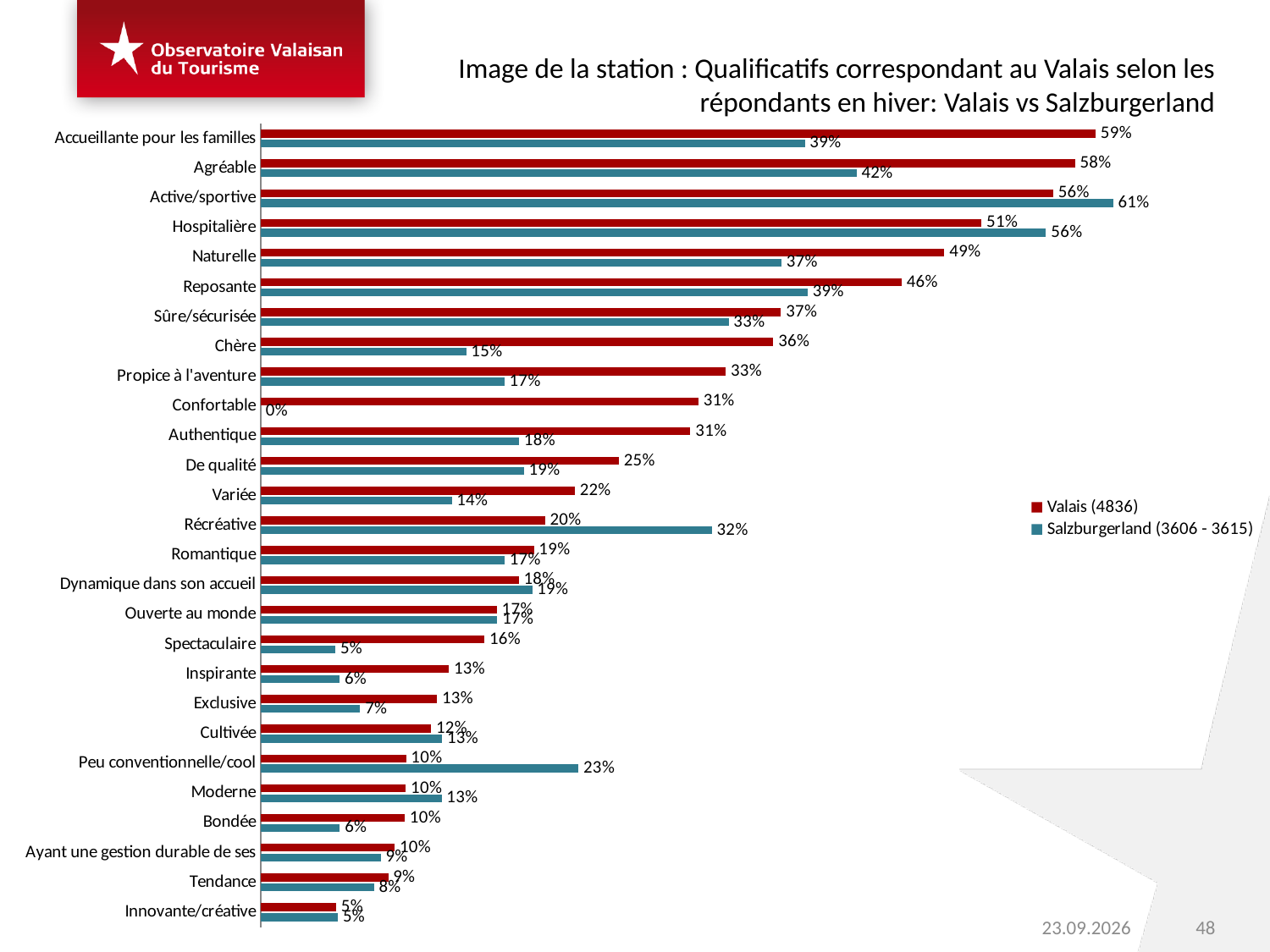
What is the Salzburgerland value for "Confortable"? 0% How many series does the legend list? 2 What are the two legend entries of the chart? Valais (4836) and Salzburgerland (3606 - 3615) Which category has the highest Salzburgerland value? Active/sportive What is the difference between the Valais and Salzburgerland values for "Chère"? 21% How many categories are shown on the chart? 27 What is the Salzburgerland value for "Récréative"? 32% What is the Valais value for "Accueillante pour les familles"? 59% For "Peu conventionnelle/cool", which is larger: the Valais value or the Salzburgerland value? Salzburgerland For "Naturelle", which is larger: the Valais value or the Salzburgerland value? Valais What kind of chart is shown on the slide? bar chart Which category has the lowest Valais value? Innovante/créative